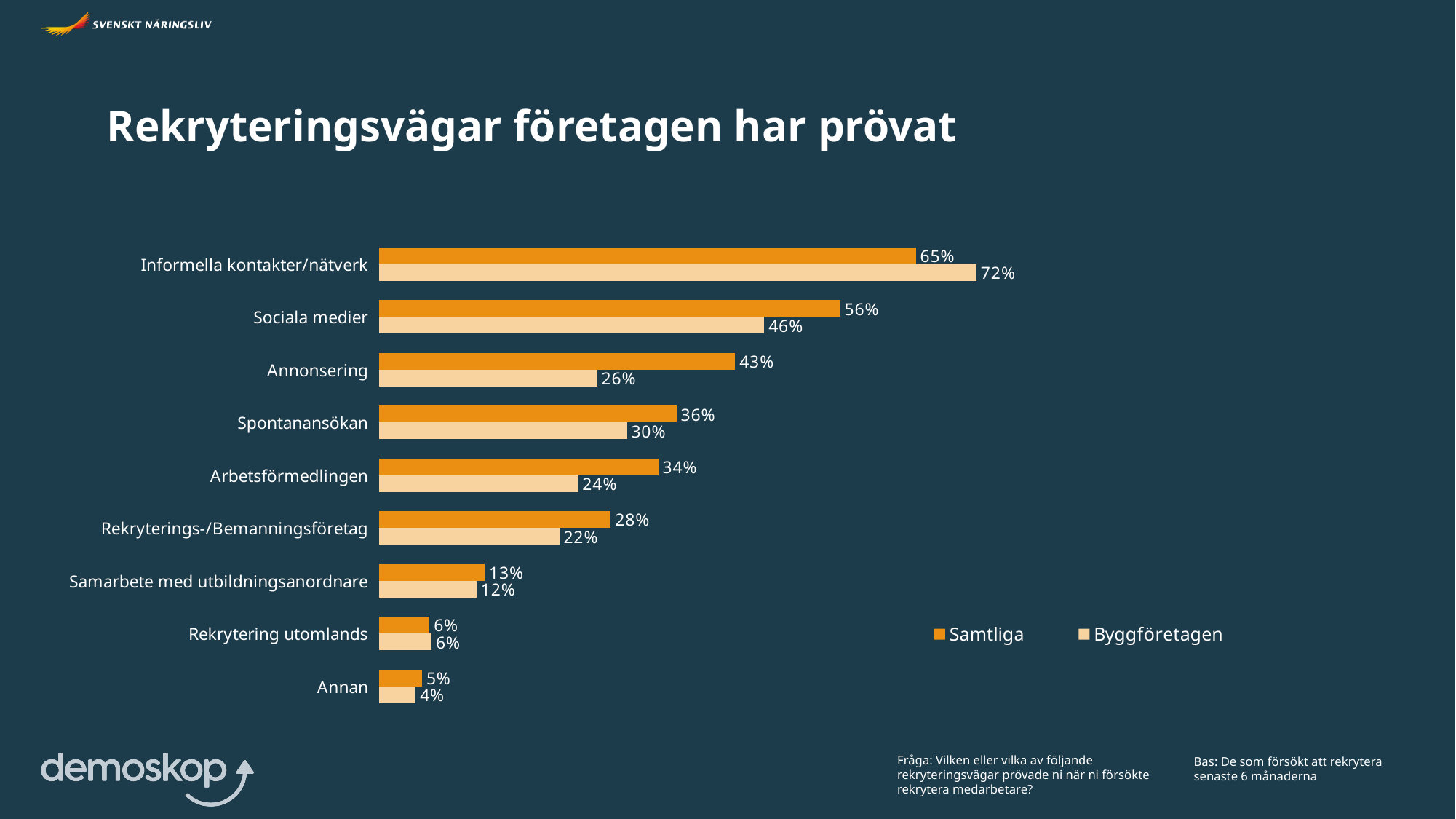
How many series does the legend list? 2 What kind of chart is shown on the slide? Bar chart What is the value for Byggföretagen for Arbetsförmedlingen? 24% How many categories are shown in the chart? 9 What is the difference between Samtliga and Byggföretagen for Annonsering? 17% What is the value for Samtliga for Sociala medier? 56% What is the title of the chart? Rekryteringsvägar företagen har prövat Which is larger for Sociala medier, Samtliga or Byggföretagen? Samtliga Which category has the highest value for Byggföretagen? Informella kontakter/nätverk What is the difference between Byggföretagen and Samtliga for Informella kontakter/nätverk? 7% What is the value for Byggföretagen for Annonsering? 26% Which category has the lowest value for Samtliga? Annan